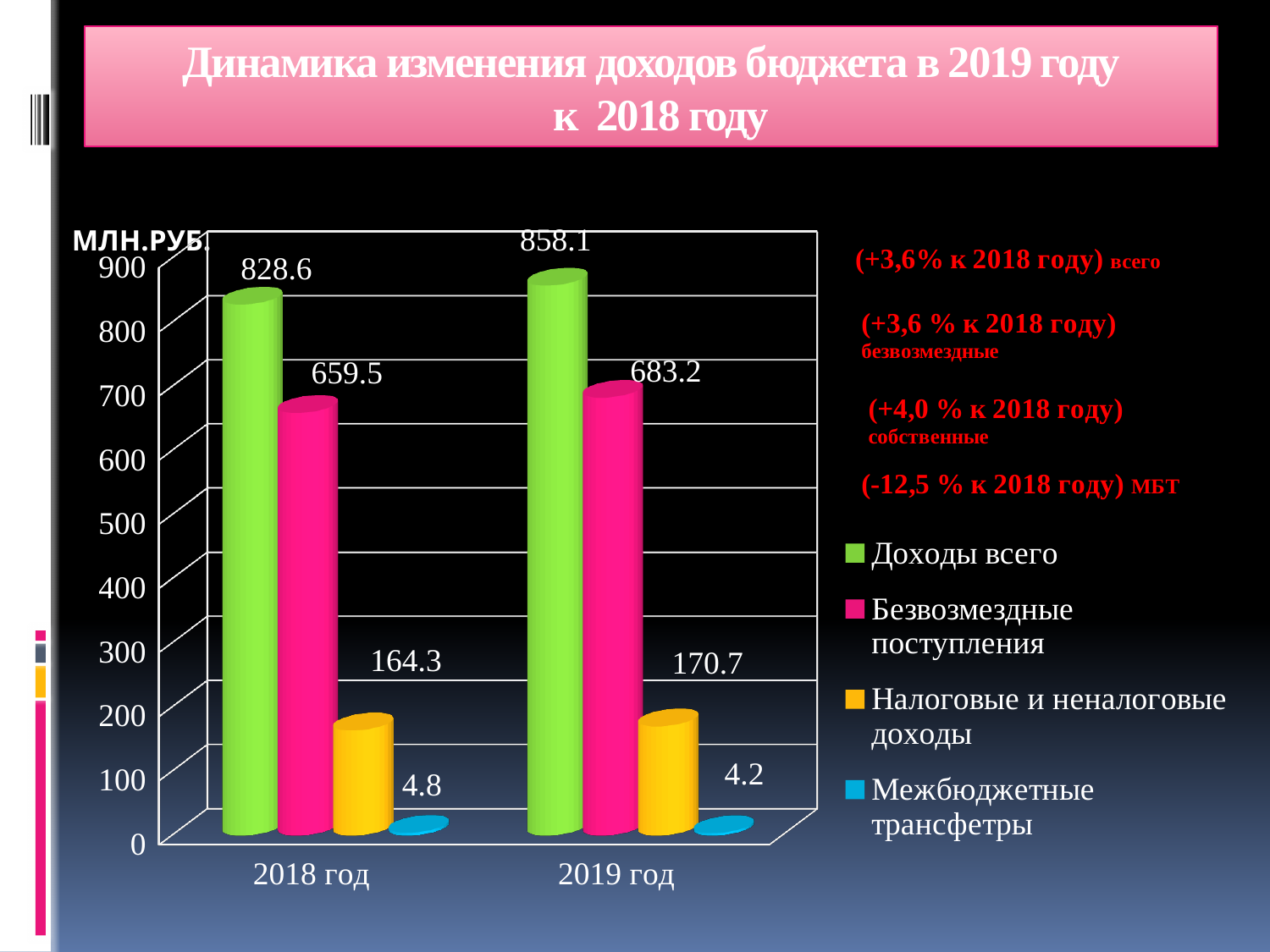
What is the difference between Доходы всего for 2019 год and 2018 год? 29.5 Which is larger: Налоговые и неналоговые доходы for 2018 год or for 2019 год? 2019 год What is the value of Безвозмездные поступления for 2019 год? 683.2 How many series does the legend list? 4 How many categories are shown on the x axis? 2 What is the value of Доходы всего for 2018 год? 828.6 What kind of chart is shown on the slide? Bar chart What is the value of Налоговые и неналоговые доходы for 2018 год? 164.3 Which series has the lowest value for 2018 год? Межбюджетные трансферты Which series has the highest value for 2019 год? Доходы всего What unit is shown on the vertical axis of the chart? МЛН.РУБ. What is the value of Межбюджетные трансферты for 2019 год? 4.2